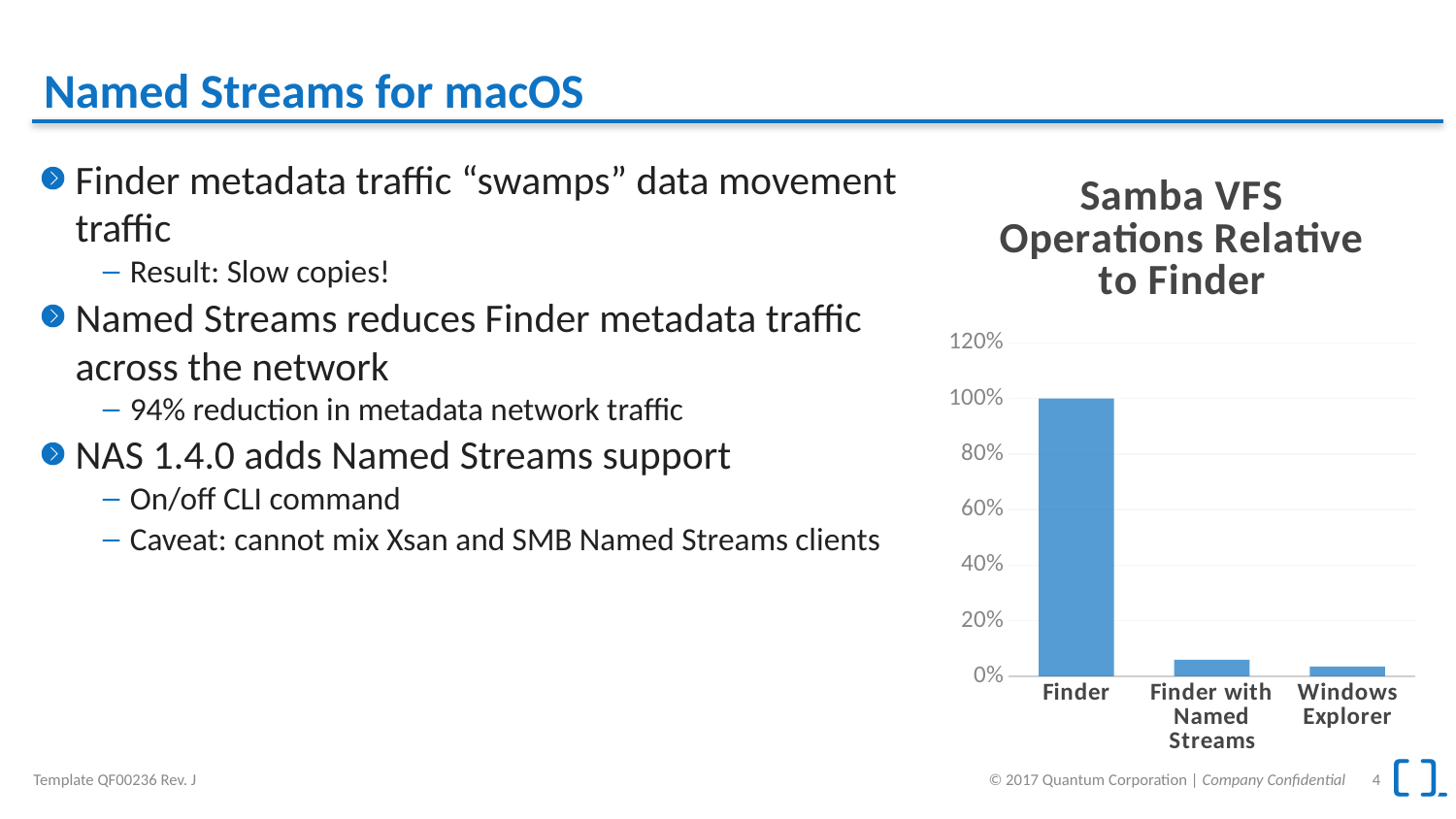
What is the title of the chart? Samba VFS Operations Relative to Finder What is the value for Finder in the chart? 100% What type of chart is shown on the slide? Bar chart Which is larger, the value for Finder or the value for Finder with Named Streams? Finder Is the value for Finder with Named Streams greater or less than 20%? less How many categories are shown on the x axis of the chart? 3 What is the highest value shown on the y axis of the chart? 120% Which category has the highest value in the chart? Finder Do the values rise or fall from left to right across the x axis? fall Is the value for Windows Explorer greater or less than 20%? less Is the value for Finder greater or less than 80%? greater Which is larger, the value for Finder or the value for Windows Explorer? Finder